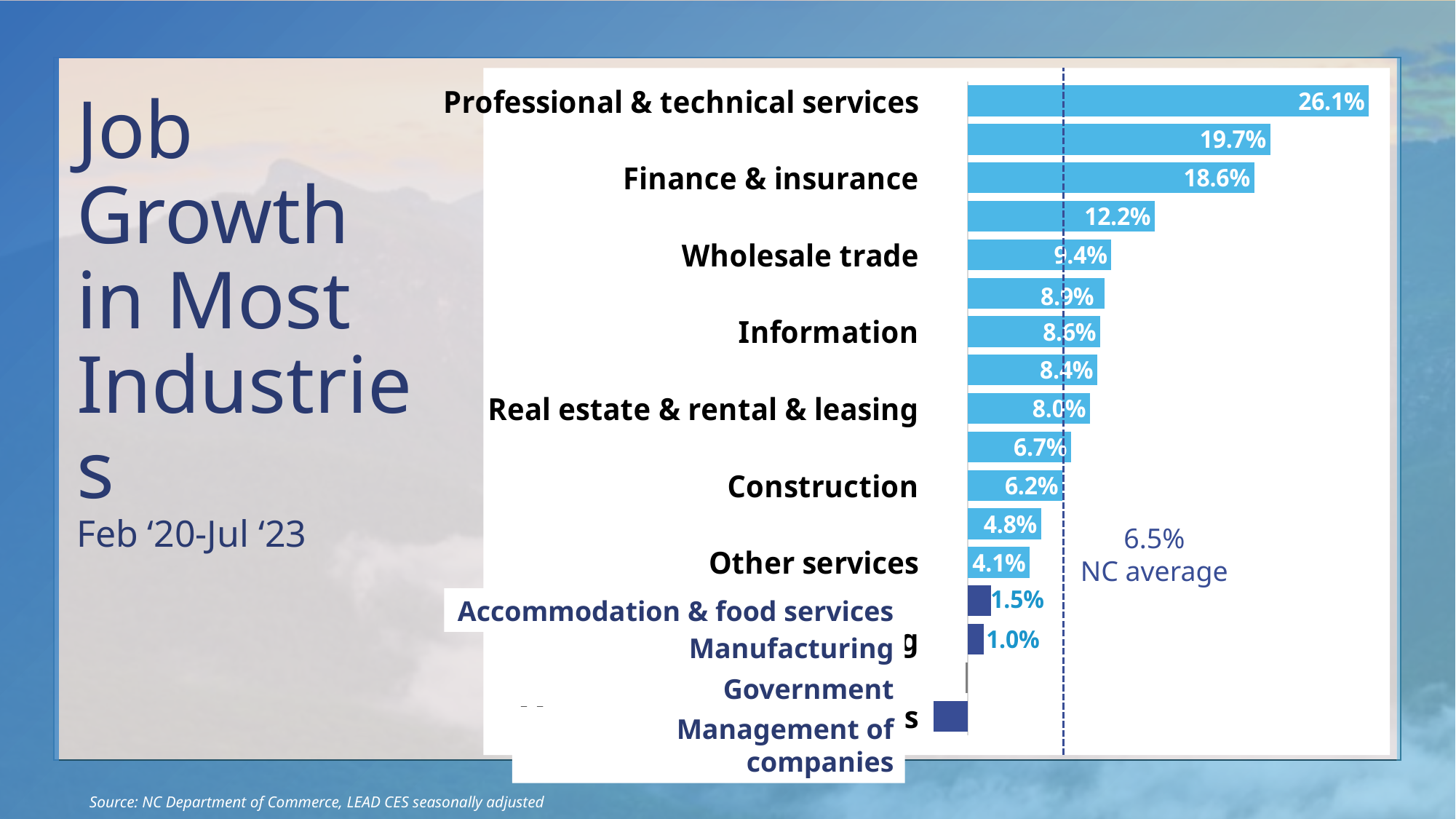
Which has higher job growth, Wholesale trade or Information? Wholesale trade What is the job growth value for Information? 8.6% What is the job growth value for Construction? 6.2% What is the job growth value for Other services? 4.1% What is the job growth value for Finance & insurance? 18.6% What is the job growth value for Real estate & rental & leasing? 8.0% Which industry has the highest job growth in the chart? Professional & technical services What value does the dashed vertical line labelled NC average represent? 6.5% What kind of chart is shown on the slide? Bar chart What is the job growth value for Wholesale trade? 9.4% What is the job growth value for Professional & technical services? 26.1% What is the difference in job growth between Professional & technical services and Finance & insurance? 7.5 percentage points